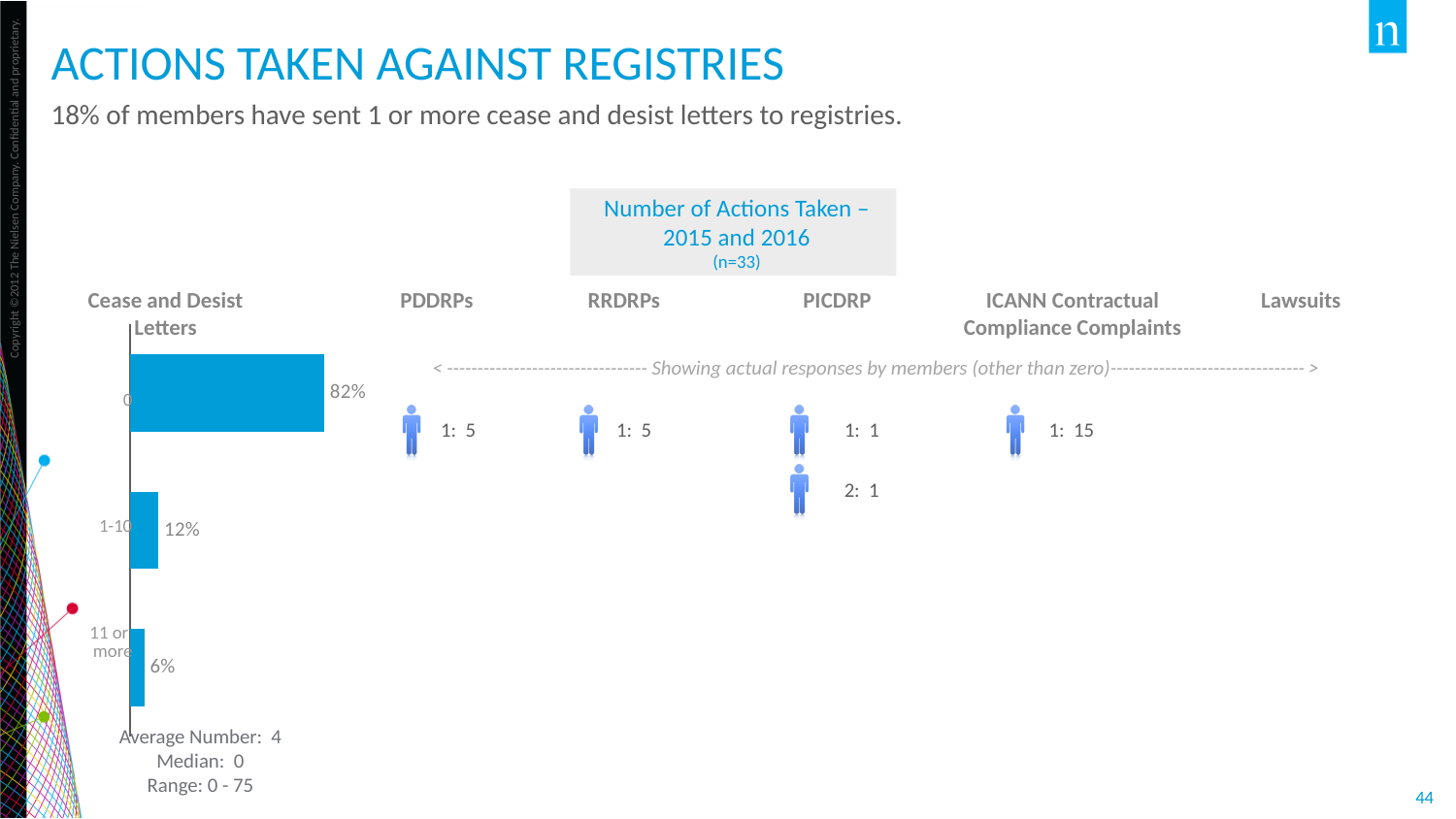
What kind of chart is the Cease and Desist Letters chart? Bar chart In the Cease and Desist Letters chart, what is the difference in percentage points between the 0 category and the 1-10 category? 70 In the Cease and Desist Letters chart, which category has the highest percentage? 0 In the Cease and Desist Letters chart, which category has the lowest percentage? 11 or more In the Cease and Desist Letters chart, what is the difference in percentage points between the 1-10 category and the 11 or more category? 6 In the Cease and Desist Letters chart, what percentage of members sent 0 cease and desist letters? 82% In the Cease and Desist Letters chart, what percentage of members sent 11 or more cease and desist letters? 6% How many categories are shown in the Cease and Desist Letters chart? 3 What is the average number of cease and desist letters stated below the Cease and Desist Letters chart? 4 In the Cease and Desist Letters chart, do the percentages rise or fall going from the 0 category down to the 11 or more category? Fall In the Cease and Desist Letters chart, what percentage of members sent 1-10 cease and desist letters? 12% In the Cease and Desist Letters chart, which is larger: the percentage for 1-10 or for 11 or more? 1-10